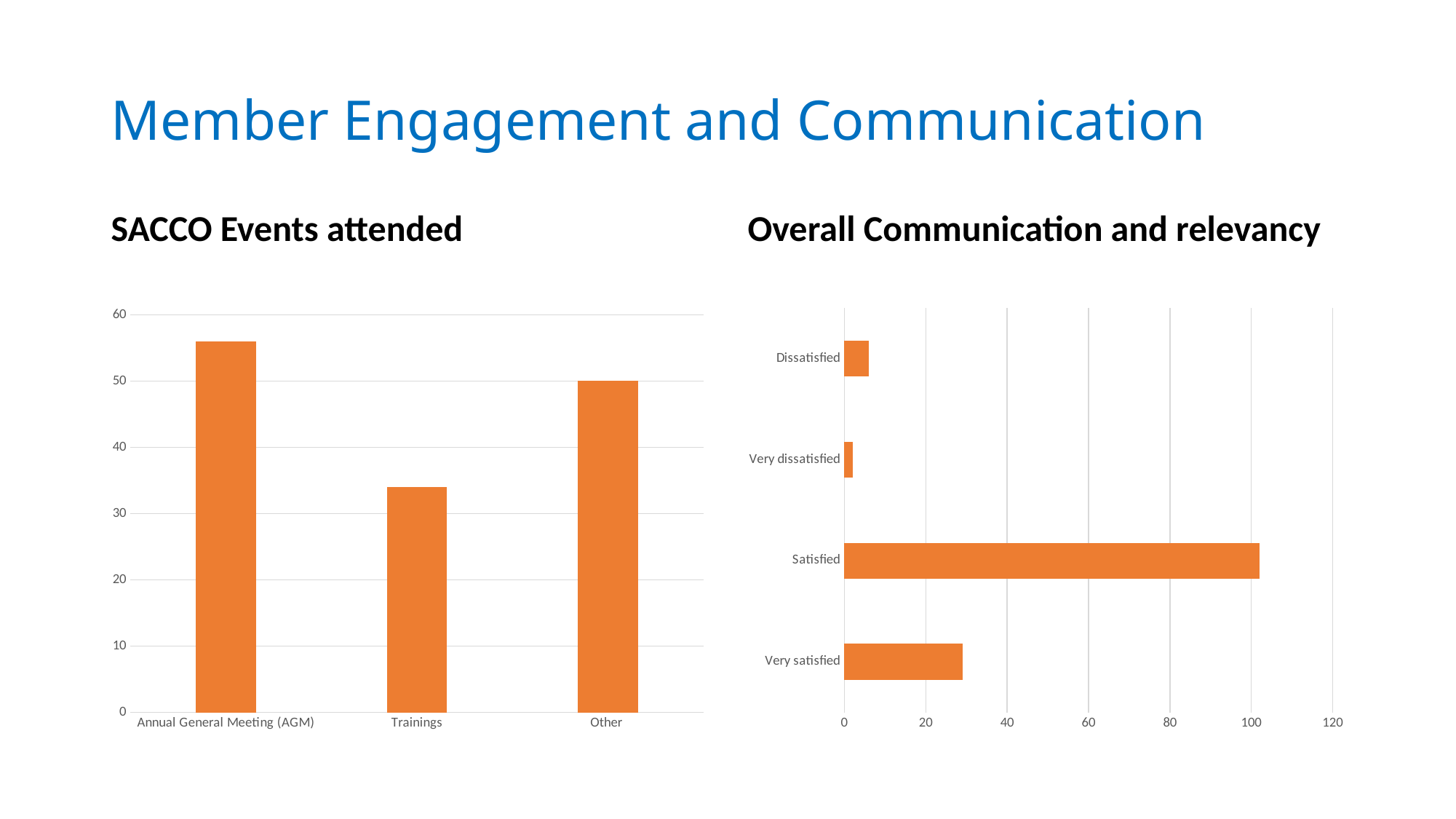
In the 'Overall Communication and relevancy' chart, is the value for Very satisfied greater or less than 20? greater What kind of chart is the 'Overall Communication and relevancy' chart? bar chart In the 'Overall Communication and relevancy' chart, which is larger, Dissatisfied or Very satisfied? Very satisfied In the 'SACCO Events attended' chart, how many categories are shown? 3 In the 'SACCO Events attended' chart, which category has the highest value? Annual General Meeting (AGM) In the 'SACCO Events attended' chart, what is the value for Other? 50 In the 'Overall Communication and relevancy' chart, which category has the lowest value? Very dissatisfied In the 'SACCO Events attended' chart, is the value for Trainings greater or less than 40? less In the 'SACCO Events attended' chart, which category has the lowest value? Trainings In the 'Overall Communication and relevancy' chart, how many categories are shown? 4 In the 'Overall Communication and relevancy' chart, which category has the highest value? Satisfied In the 'SACCO Events attended' chart, is the value for Annual General Meeting (AGM) greater or less than 50? greater